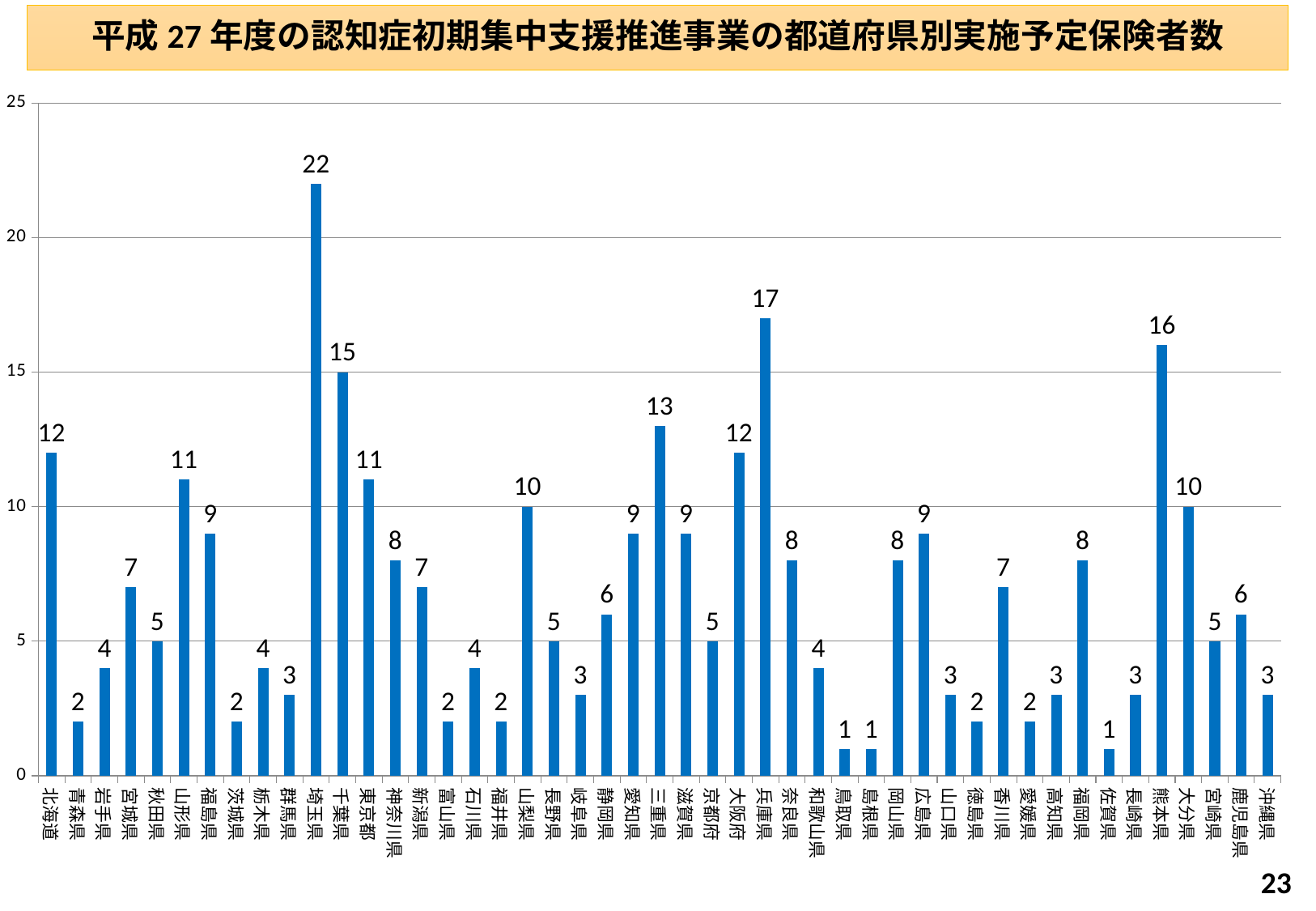
What is the value for 兵庫県? 17 What is the value for 鳥取県? 1 What is the difference between the values for 兵庫県 and 奈良県? 9 What is the title of the chart? 平成27年度の認知症初期集中支援推進事業の都道府県別実施予定保険者数 What is the value for 埼玉県? 22 How many prefectures (bars) are shown on the chart? 47 Which prefecture has the highest value? 埼玉県 What is the difference between the values for 埼玉県 and 千葉県? 7 What is the value for 熊本県? 16 Which has a larger value, 北海道 or 山形県? 北海道 Which has a larger value, 三重県 or 大阪府? 三重県 What kind of chart is shown on the slide? Bar chart